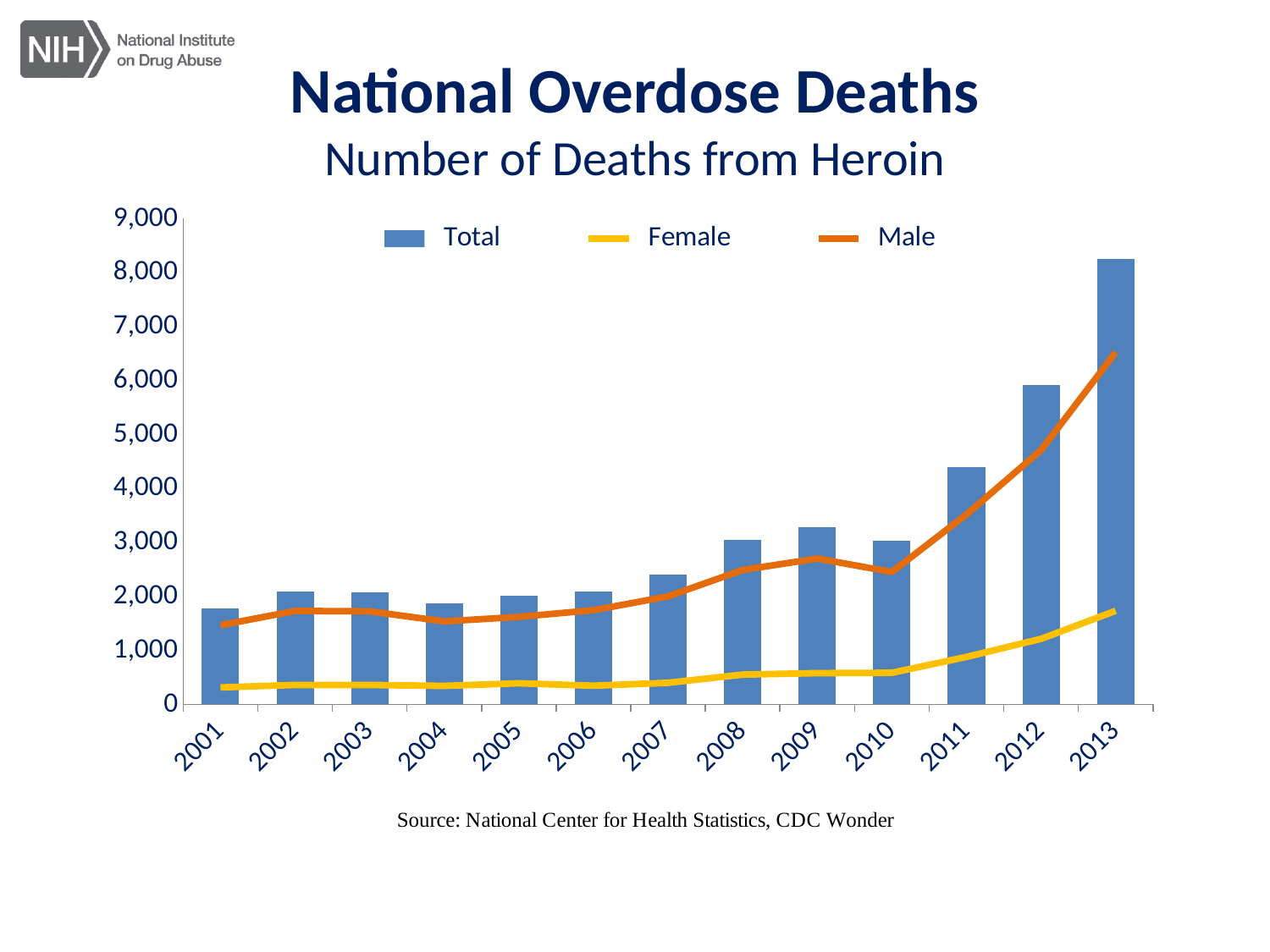
Is the Female value for 2001 greater or less than 1,000? less In 2013, which is larger, the Male value or the Female value? Male Which series is drawn as bars rather than a line? Total What kind of chart is shown on the slide? A combined bar and line chart Is the Male value for 2013 greater or less than 6,000? greater Is the Total value for 2011 greater or less than 4,000? greater Does the Total number of heroin deaths generally rise or fall from 2001 to 2013? Rise Which year has the highest Total number of heroin deaths? 2013 How many series does the legend list? 3 How many years are shown on the x axis? 13